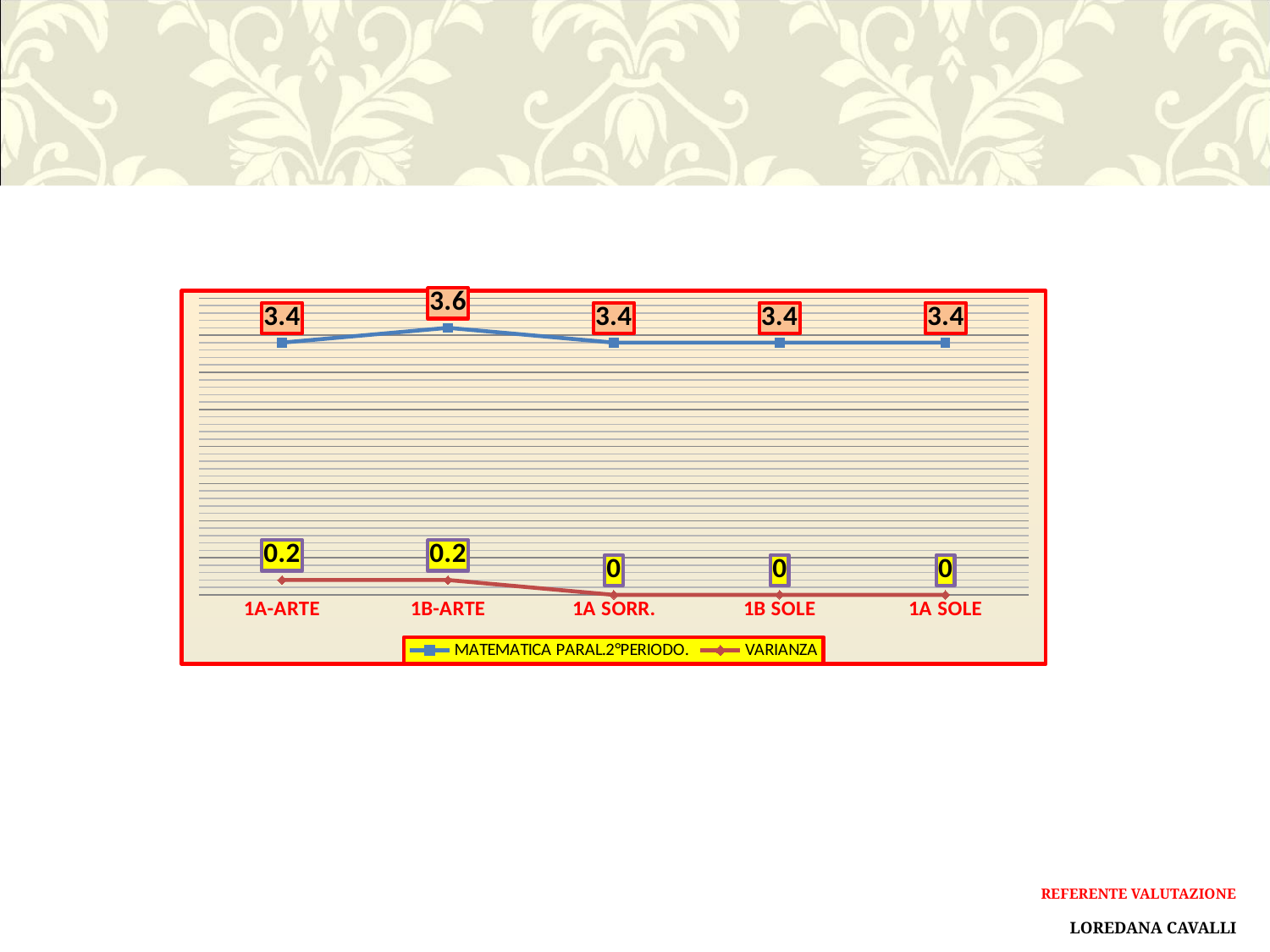
Which is larger, the VARIANZA value for 1B-ARTE or for 1A SOLE? 1B-ARTE Which category has the highest MATEMATICA PARAL.2°PERIODO. value? 1B-ARTE What kind of chart is shown on the slide? line chart What are the two series names listed in the legend? MATEMATICA PARAL.2°PERIODO. and VARIANZA How many categories are shown on the x axis? 5 Does the VARIANZA series rise or fall from 1B-ARTE to 1A SORR.? fall What is the VARIANZA value for 1A-ARTE? 0.2 What is the VARIANZA value for 1B SOLE? 0 How many series does the legend list? 2 What is the MATEMATICA PARAL.2°PERIODO. value for 1A SORR.? 3.4 What is the difference between the MATEMATICA PARAL.2°PERIODO. values for 1B-ARTE and 1A-ARTE? 0.2 What is the MATEMATICA PARAL.2°PERIODO. value for 1B-ARTE? 3.6